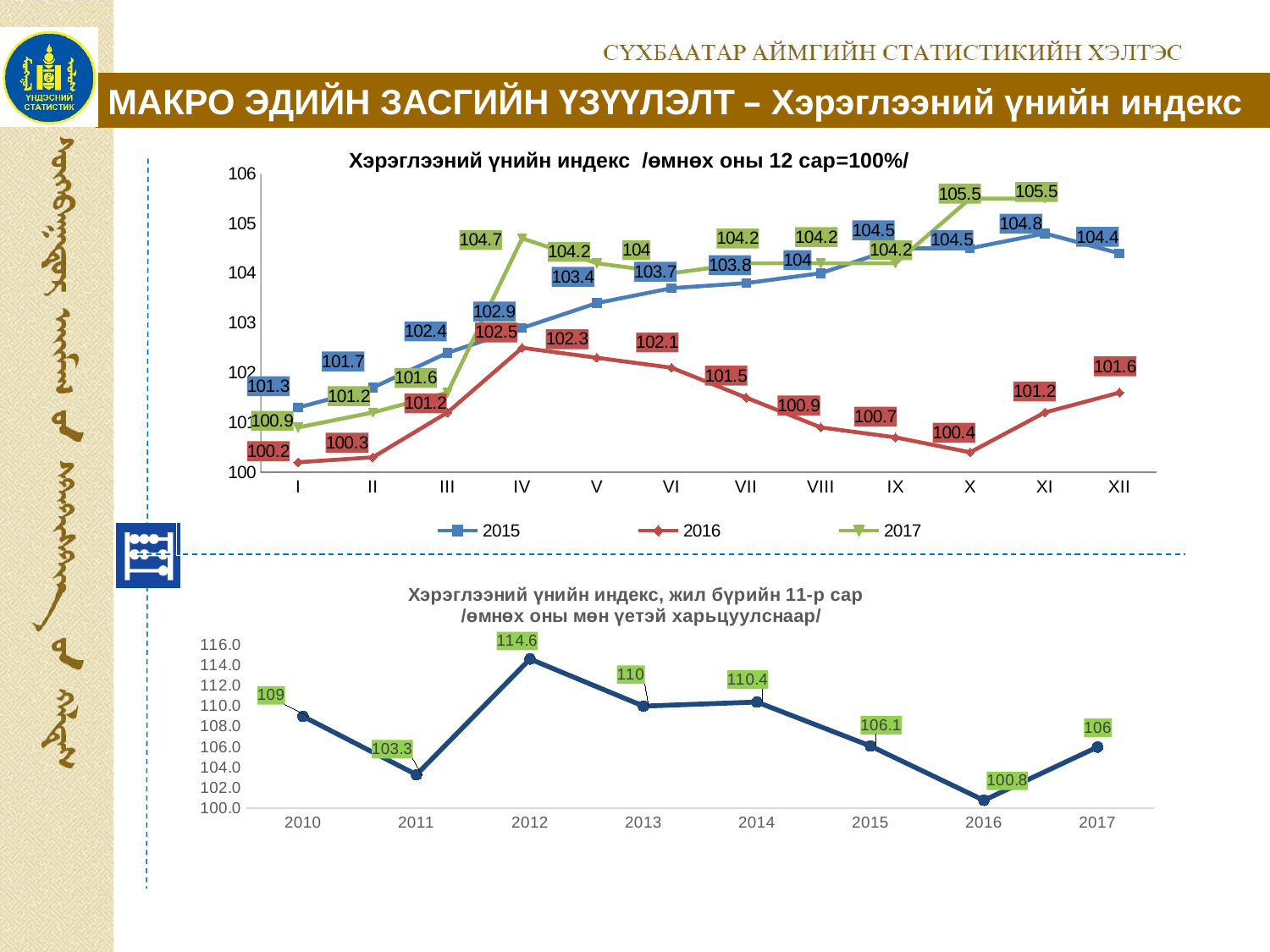
In the bottom chart, which year has the highest value? 2012 How many years are plotted in the bottom chart? 8 In the top chart (Хэрэглээний үнийн индекс /өмнөх оны 12 сар=100%/), how many series does the legend list? 3 What kind of chart is the bottom chart (Хэрэглээний үнийн индекс, жил бүрийн 11-р сар)? line chart In the top chart, in which month is the 2016 series lowest? I In the top chart, what is the value of the 2015 series for month XI? 104.8 In the bottom chart, what is the difference between the values for 2012 and 2011? 11.3 In the top chart, what is the value of the 2017 series for month IV? 104.7 In the top chart, what is the value of the 2016 series for month XII? 101.6 In the bottom chart, which year has the lowest value? 2016 In the top chart, what is the difference between the 2015 and 2016 values for month XII? 2.8 In the top chart, which is larger for month IV: the 2017 value or the 2015 value? 2017